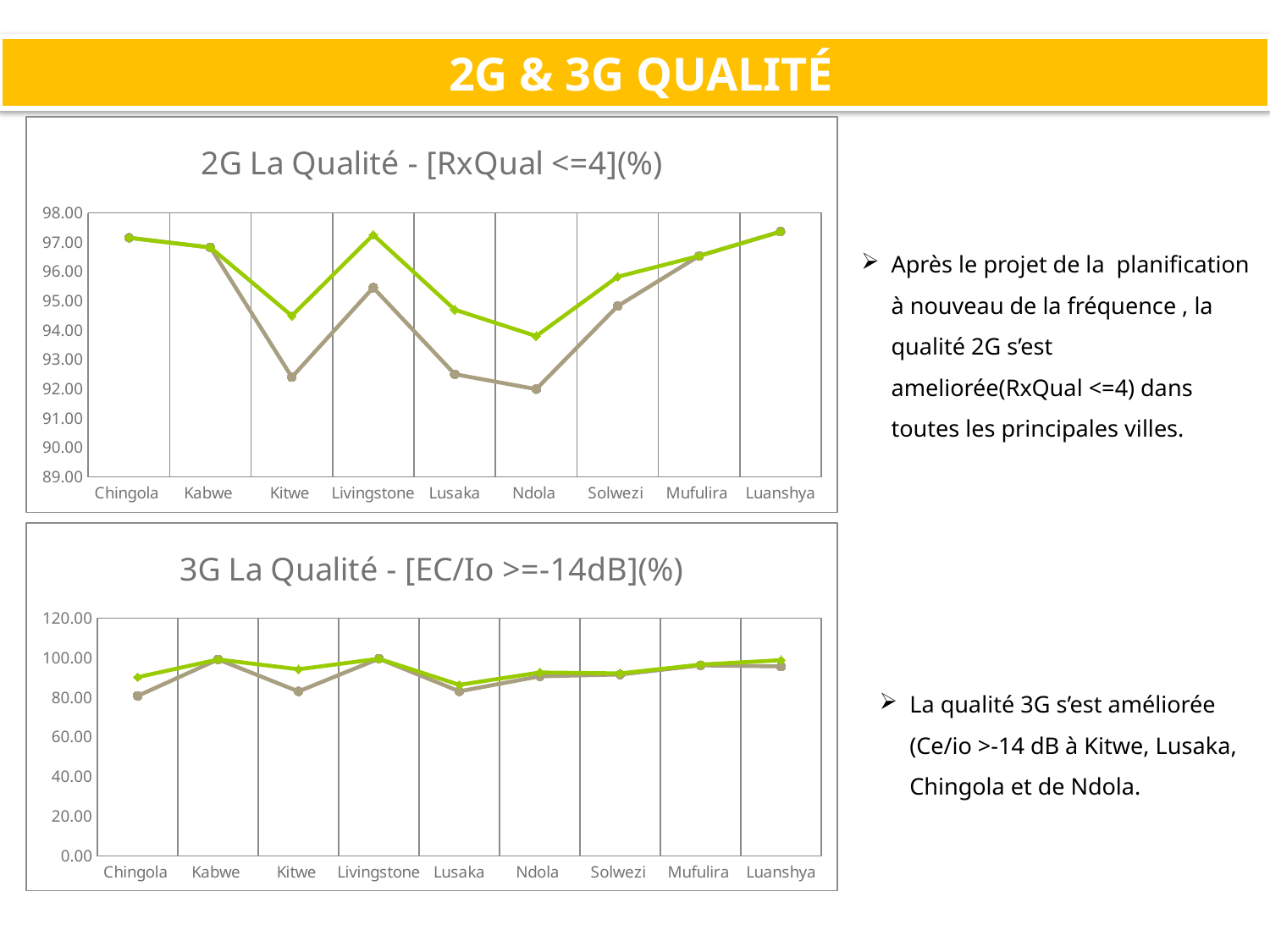
In the '3G La Qualité - [EC/Io >=-14dB](%)' chart, is the brown line's value for Chingola greater or less than 100.00? less In the '2G La Qualité - [RxQual <=4](%)' chart, at Kitwe, which line is higher, the green line or the brown line? the green line What is the title of the lower chart on the slide? 3G La Qualité - [EC/Io >=-14dB](%) In the '3G La Qualité - [EC/Io >=-14dB](%)' chart, at Chingola, which line is higher, the green line or the brown line? the green line In the '2G La Qualité - [RxQual <=4](%)' chart, which city has the lowest value on the green line? Ndola How many lines are plotted in the '3G La Qualité - [EC/Io >=-14dB](%)' chart? 2 In the '2G La Qualité - [RxQual <=4](%)' chart, does the green line rise or fall from Ndola to Luanshya? rise In the '2G La Qualité - [RxQual <=4](%)' chart, is the brown line's value for Livingstone greater or less than 95.00? greater What type of chart is the '3G La Qualité - [EC/Io >=-14dB](%)' chart? line chart What type of chart is the '2G La Qualité - [RxQual <=4](%)' chart? line chart How many cities are shown on the x axis of the '2G La Qualité - [RxQual <=4](%)' chart? 9 In the '2G La Qualité - [RxQual <=4](%)' chart, is the brown line's value for Kitwe greater or less than 93.00? less